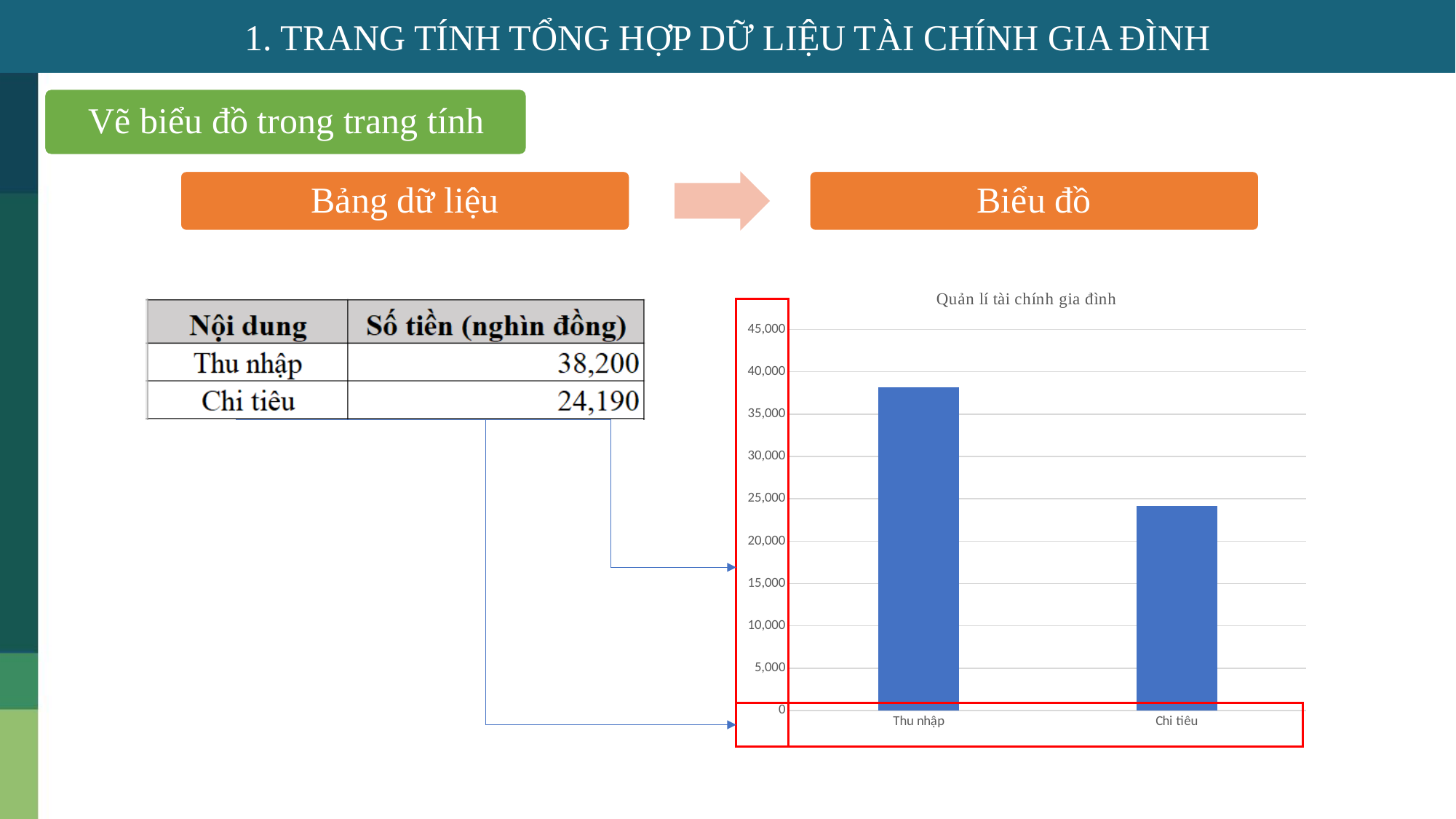
Which is larger, the bar for Thu nhập or the bar for Chi tiêu? Thu nhập Which category has the highest bar in the chart? Thu nhập Using the values in the data table, what is the difference between Thu nhập and Chi tiêu? 14,010 Is the bar for Chi tiêu greater or less than 25,000? less Which category has the lowest bar in the chart? Chi tiêu What is the title of the chart? Quản lí tài chính gia đình What kind of chart is shown on the slide? bar chart How many categories are plotted on the chart? 2 According to the data table the chart is drawn from, what is the value for Chi tiêu? 24,190 What is the highest value labelled on the chart's vertical axis? 45,000 Is the bar for Thu nhập greater or less than 35,000? greater According to the data table the chart is drawn from, what is the value for Thu nhập? 38,200